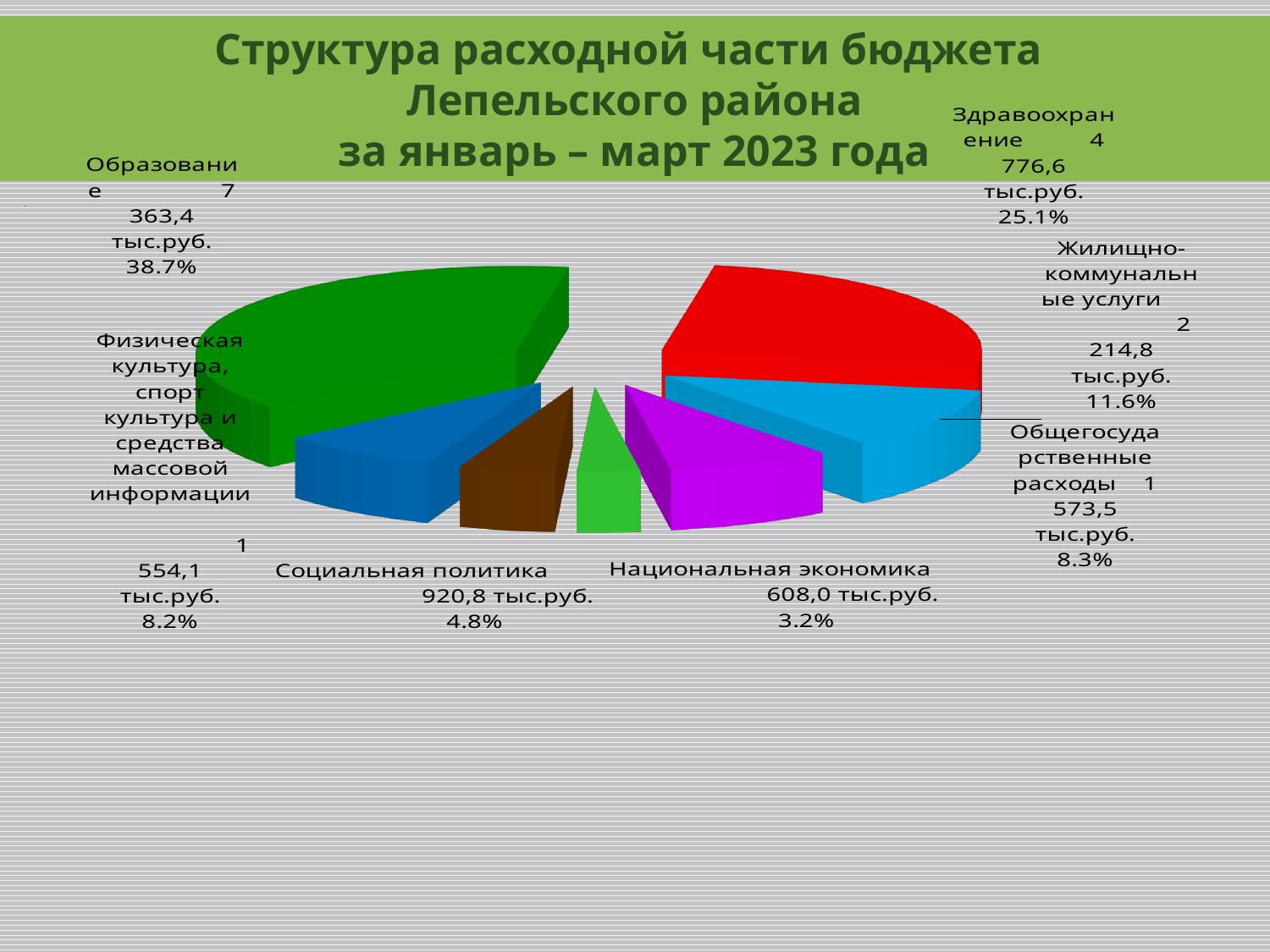
What share of the budget expenditure goes to Жилищно-коммунальные услуги? 11.6% How many slices does the pie chart have? 7 What kind of chart is shown on the slide? Pie chart What is the value for Социальная политика? 920,8 тыс.руб. What is the title of the chart? Структура расходной части бюджета Лепельского района за январь – март 2023 года Which is larger, the share for Общегосударственные расходы or for Социальная политика? Общегосударственные расходы What is the difference in percentage points between the shares for Образование and Здравоохранение? 13.6 Which category has the largest share of the budget expenditure? Образование What is the value for Здравоохранение? 4 776,6 тыс.руб. Which category has the smallest share of the budget expenditure? Национальная экономика What is the value for Национальная экономика? 608,0 тыс.руб. What share of the budget expenditure goes to Образование? 38.7%